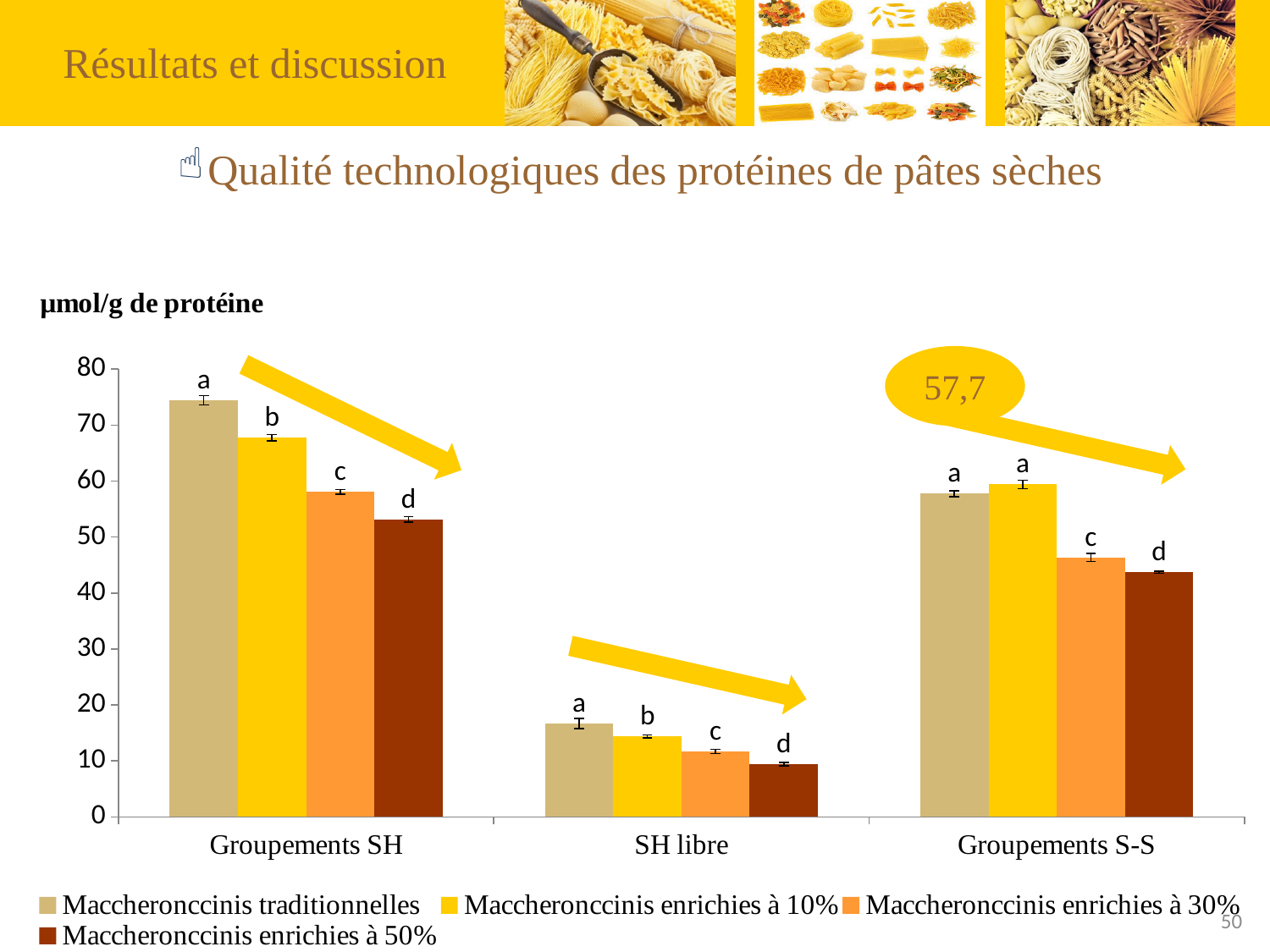
Within the Groupements SH category, which series has the highest bar? Maccheronccinis traditionnelles How many categories are shown on the x axis of the chart? 3 What kind of chart is shown on the slide? bar chart What unit is given for the y axis of the chart? µmol/g de protéine How many series does the chart legend list? 4 Is the value for Maccheronccinis enrichies à 50% in Groupements S-S greater or less than 50? less Which category has the lowest bars overall in the chart? SH libre Which is larger: the value for Maccheronccinis enrichies à 30% in Groupements SH or in Groupements S-S? Groupements SH Within the Groupements SH category, do the bars rise or fall as the enrichment level increases from traditionnelles to 50%? fall Which category has the highest bar for Maccheronccinis traditionnelles? Groupements SH Is the value for Maccheronccinis traditionnelles in Groupements SH greater or less than 70? greater